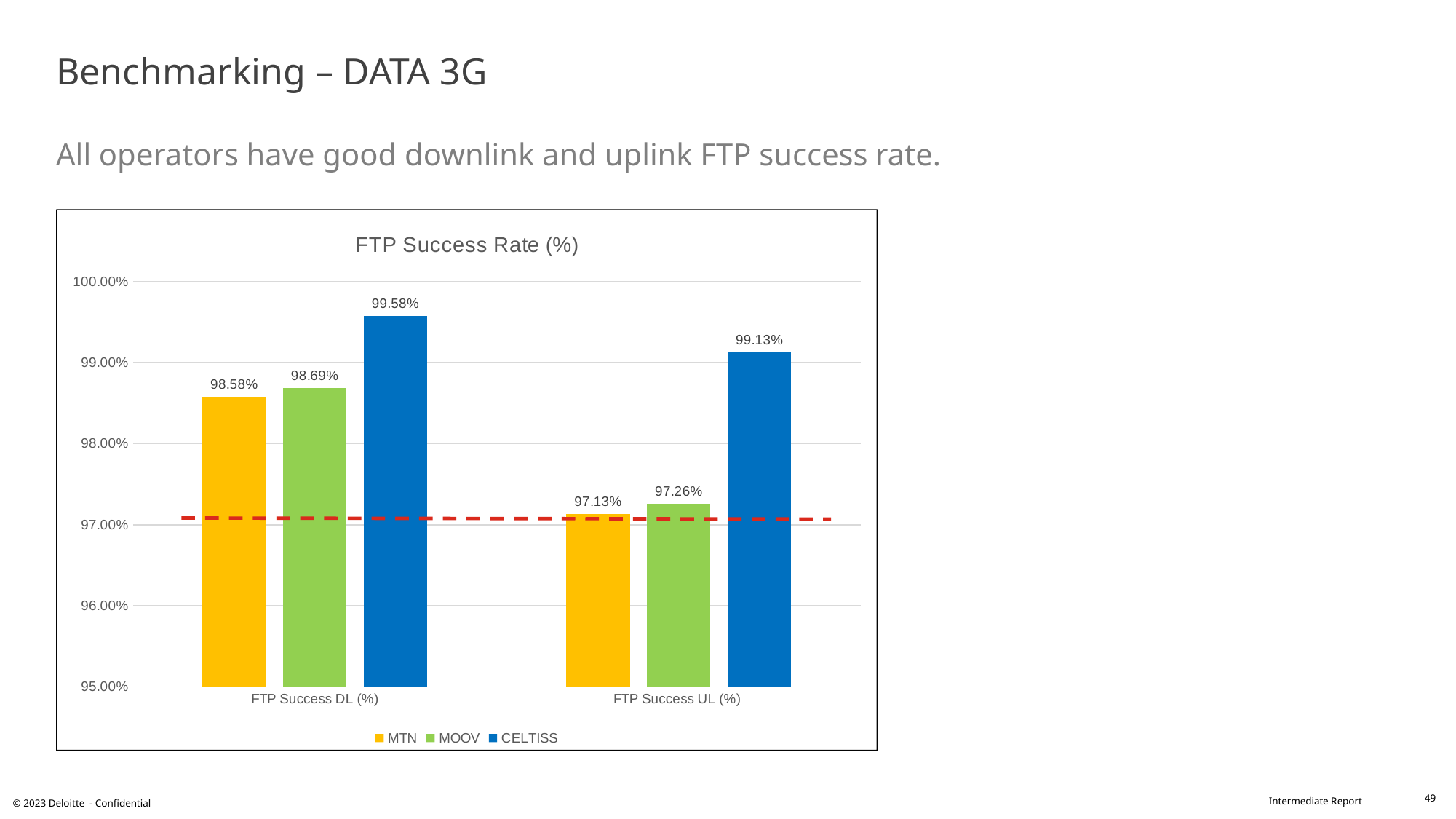
Which is larger: MOOV's FTP Success UL (%) or MTN's FTP Success UL (%)? MOOV's FTP Success UL (%) What is the FTP Success UL (%) value for CELTISS? 99.13% What kind of chart is shown on the slide? Bar chart What is the difference between CELTISS's FTP Success DL (%) and its FTP Success UL (%)? 0.45% What is the FTP Success DL (%) value for MOOV? 98.69% Which operator has the lowest FTP Success DL (%)? MTN Is the value for MTN in FTP Success DL (%) greater or less than 98.00%? greater What is the FTP Success DL (%) value for CELTISS? 99.58% How many series does the legend list? 3 Which operator has the highest FTP Success UL (%)? CELTISS What is the FTP Success UL (%) value for MTN? 97.13% What is the title of the chart? FTP Success Rate (%)